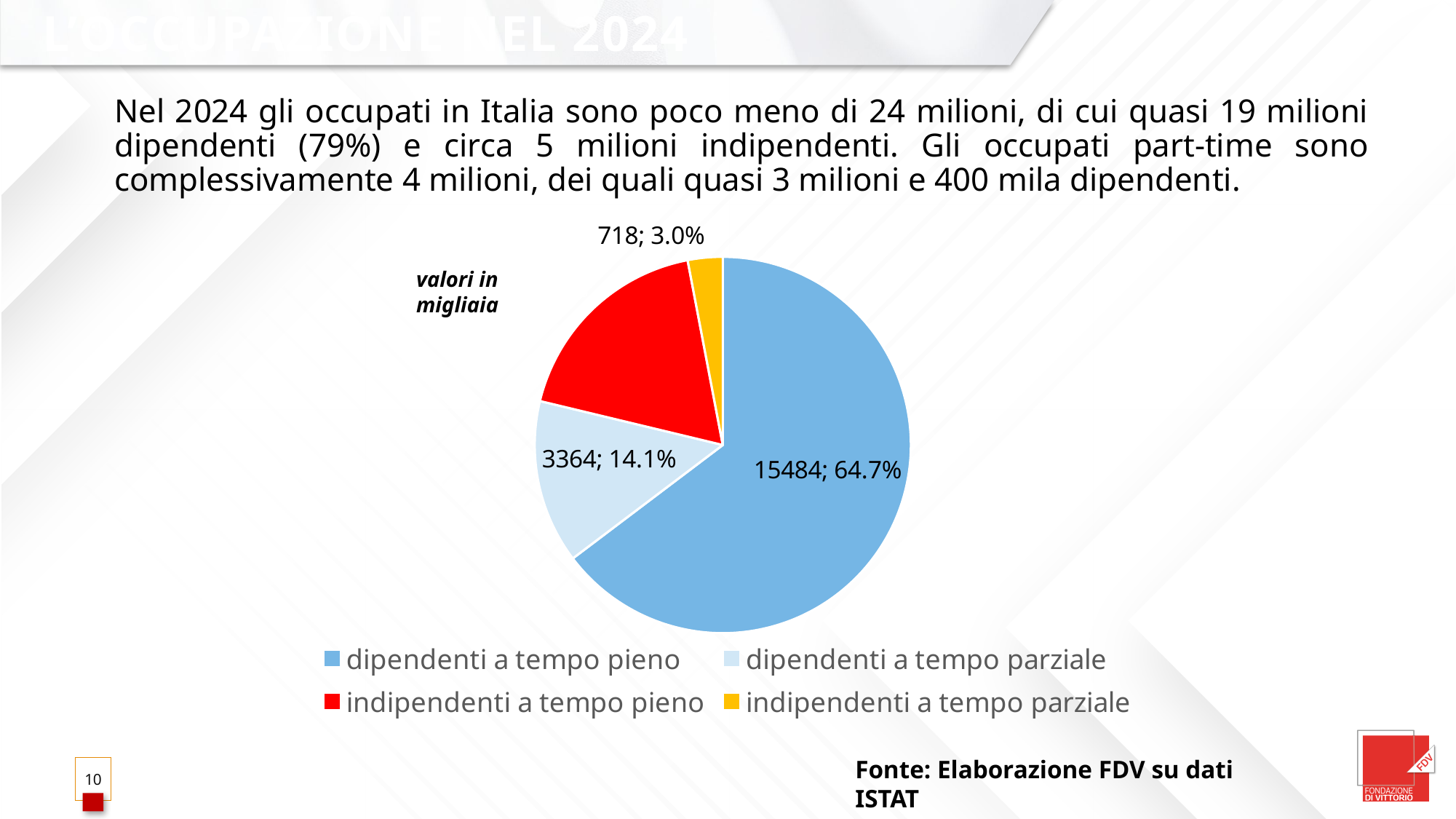
How many slices does the pie chart have? 4 What is the value shown for 'dipendenti a tempo pieno'? 15484 What is the difference between the values for 'dipendenti a tempo pieno' and 'dipendenti a tempo parziale'? 12120 What kind of chart is shown on the slide? pie chart How many entries does the legend of the pie chart list? 4 In what unit are the values of the pie chart expressed, according to the note next to it? valori in migliaia Which category has the smallest slice of the pie? indipendenti a tempo parziale What share of the pie does 'dipendenti a tempo pieno' represent? 64.7% Which slice is larger: 'indipendenti a tempo pieno' or 'dipendenti a tempo parziale'? indipendenti a tempo pieno What is the value shown for 'dipendenti a tempo parziale'? 3364 Which category has the largest slice of the pie? dipendenti a tempo pieno What share of the pie does 'indipendenti a tempo parziale' represent? 3.0%